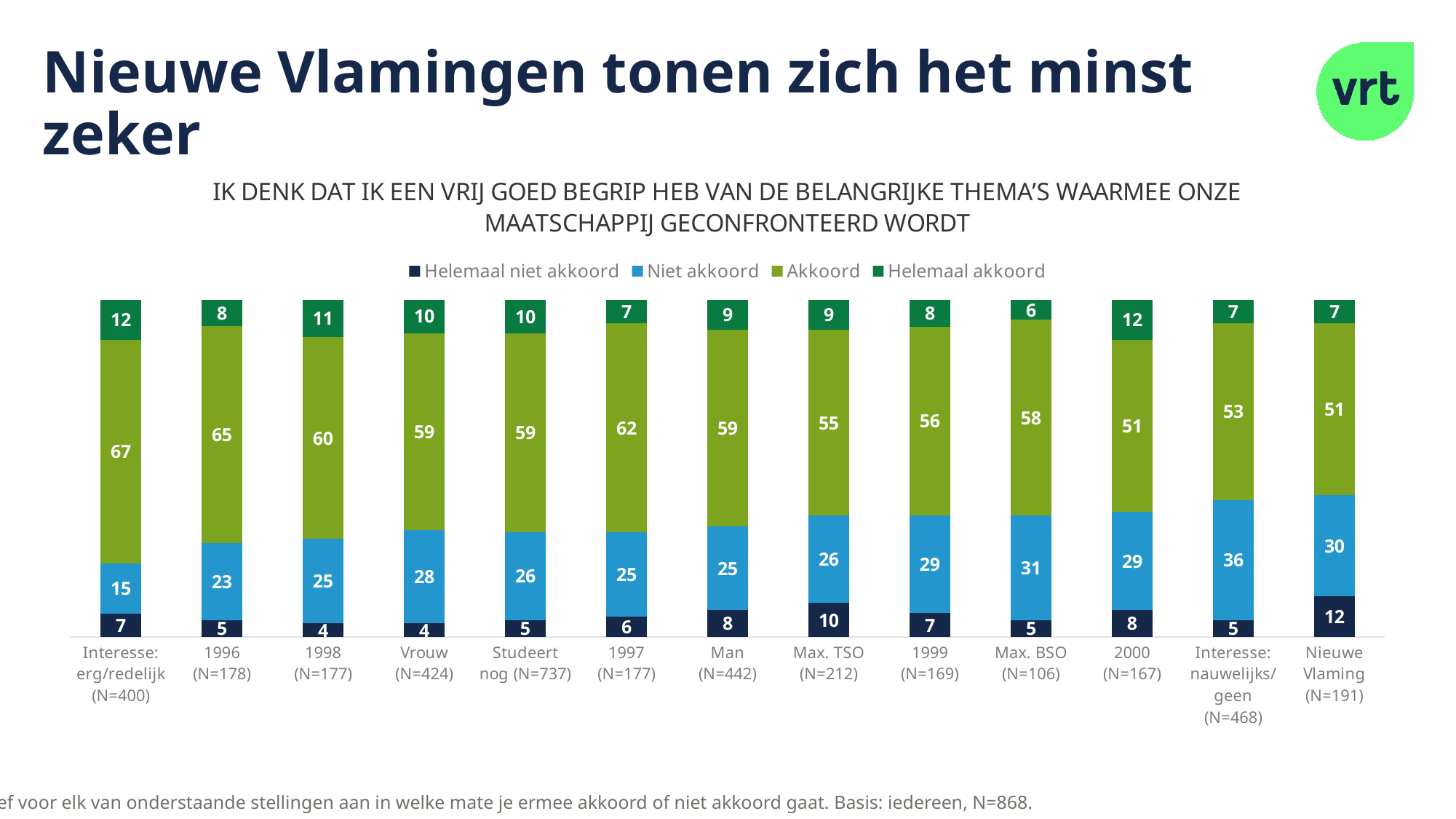
Which category has the highest Akkoord value? Interesse: erg/redelijk (N=400) Which has a larger Niet akkoord value, Vrouw (N=424) or Man (N=442)? Vrouw (N=424) Which category has the highest Helemaal niet akkoord value? Nieuwe Vlaming (N=191) Which category has the lowest Helemaal akkoord value? Max. BSO (N=106) Which category has the lowest Niet akkoord value? Interesse: erg/redelijk (N=400) What kind of chart is shown on the slide? Stacked bar chart What is the Niet akkoord value for Vrouw (N=424)? 28 What is the Helemaal akkoord value for 2000 (N=167)? 12 What is the Akkoord value for Nieuwe Vlaming (N=191)? 51 What is the difference between the Akkoord values for Interesse: erg/redelijk (N=400) and Nieuwe Vlaming (N=191)? 16 How many series does the legend list? 4 How many categories are shown on the x axis? 13